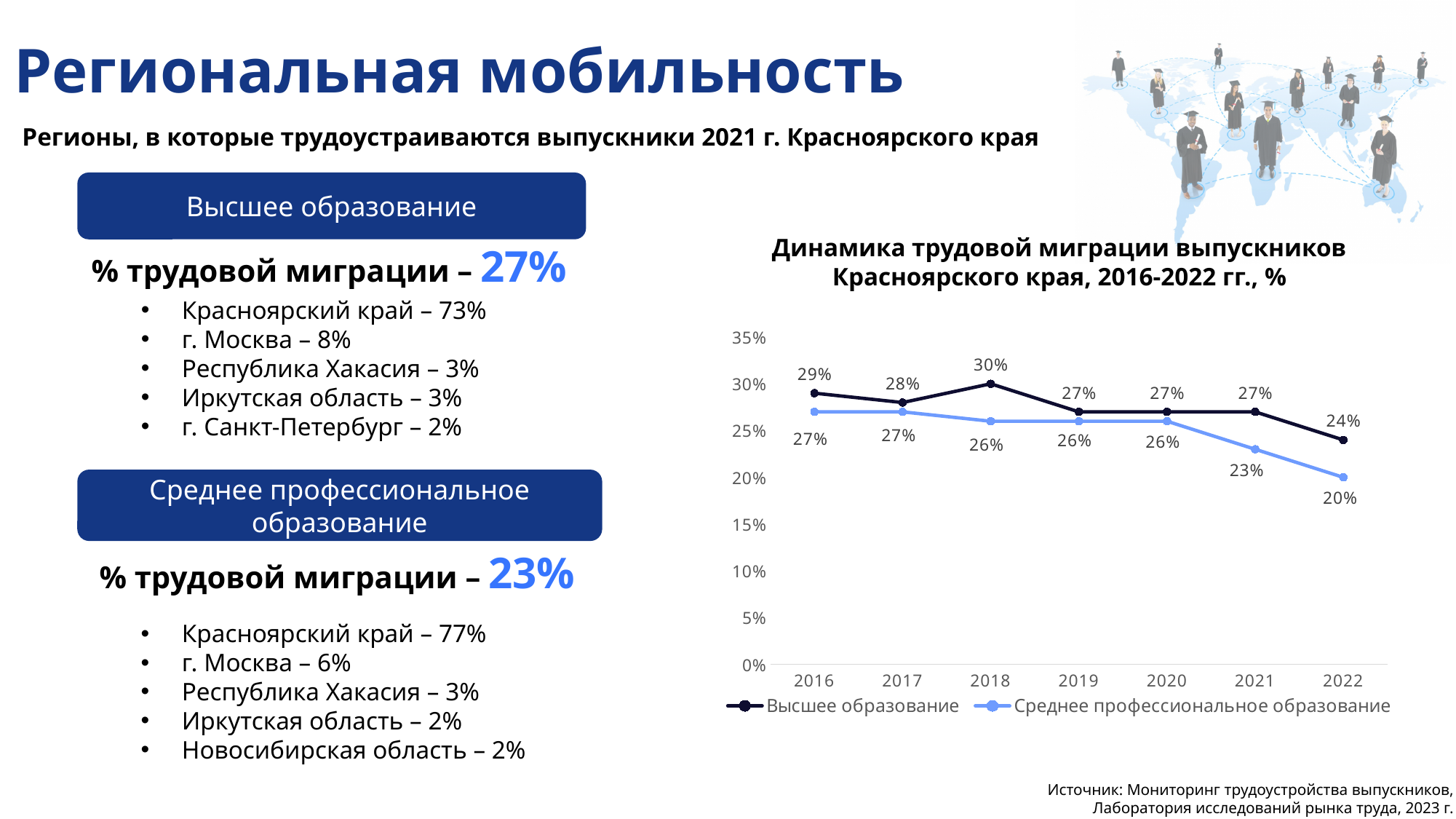
In which year is the Среднее профессиональное образование series at its lowest? 2022 What kind of chart is shown on the slide? line chart What is the value for Среднее профессиональное образование in 2022? 20% What is the value for Высшее образование in 2018? 30% Which series has the larger value in 2021, Высшее образование or Среднее профессиональное образование? Высшее образование How many years are plotted on the x axis of the chart? 7 How many series does the chart legend list? 2 What is the difference between Высшее образование and Среднее профессиональное образование in 2022? 4% What is the title of the chart? Динамика трудовой миграции выпускников Красноярского края, 2016-2022 гг., % In which year is the Высшее образование series at its highest? 2018 What is the value for Среднее профессиональное образование in 2021? 23% Does the Среднее профессиональное образование series rise or fall from 2020 to 2022? fall